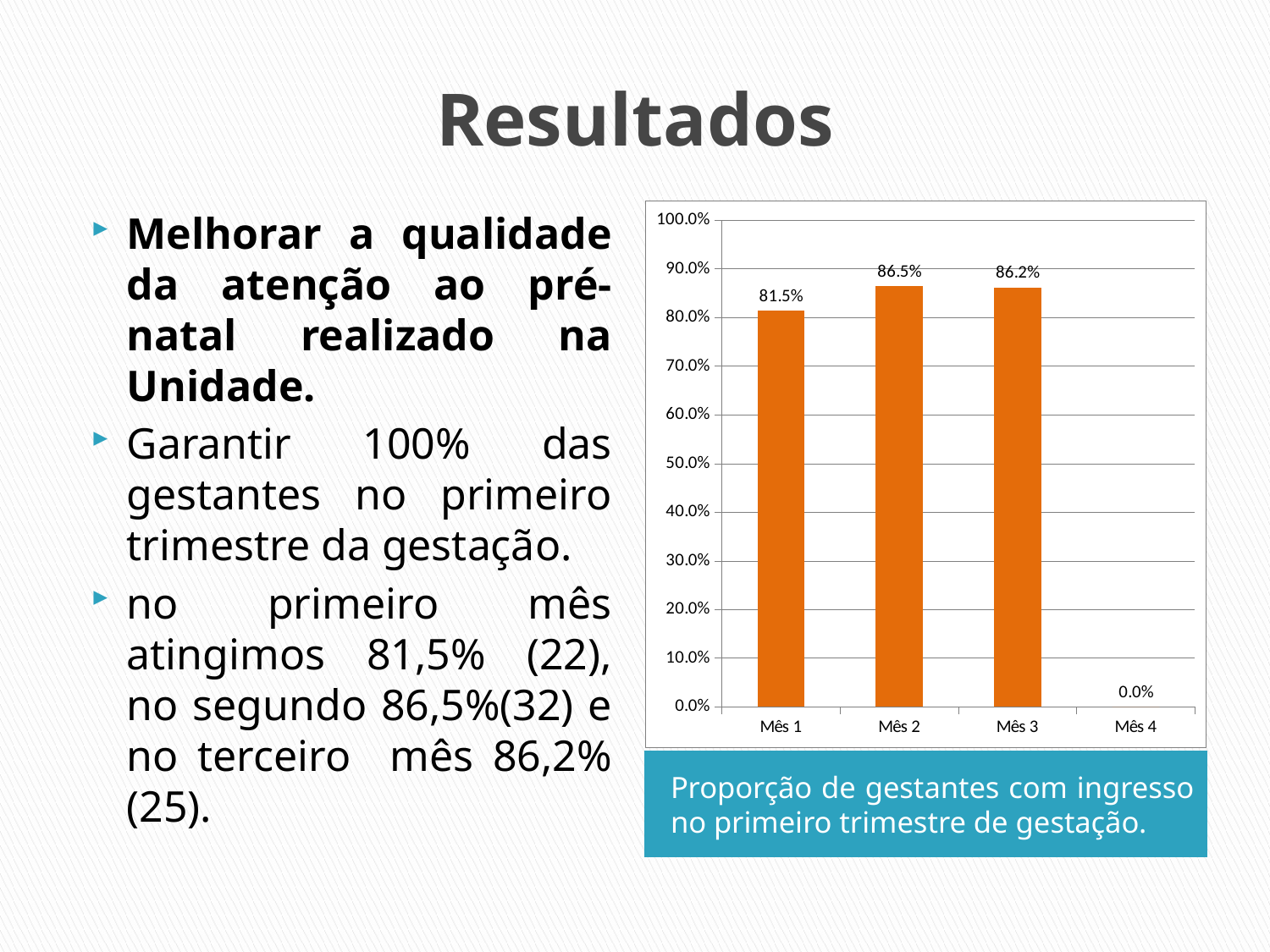
What is the caption shown below the chart? Proporção de gestantes com ingresso no primeiro trimestre de gestação. Which month has the lowest value? Mês 4 What is the difference between the values for Mês 2 and Mês 1? 5.0% Which is larger, the value for Mês 1 or the value for Mês 3? Mês 3 Which month has the highest value? Mês 2 What kind of chart is shown on the slide? bar chart What is the value for Mês 4? 0.0% What is the value for Mês 2? 86.5% What is the value for Mês 1? 81.5% Is the value for Mês 1 greater or less than 80.0%? greater What is the value for Mês 3? 86.2% How many months are shown on the x axis? 4